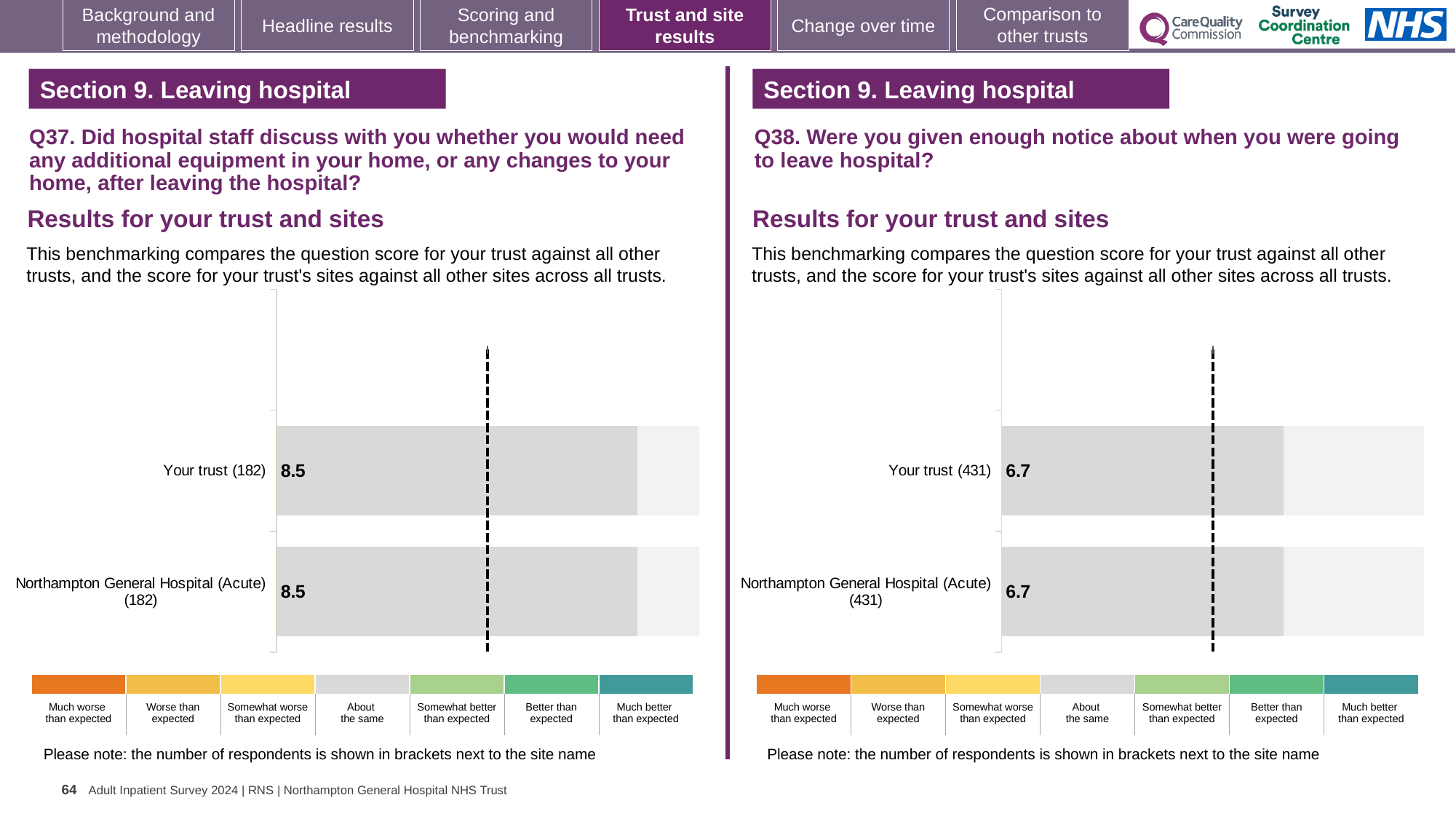
In the Q38 chart on the right, what is the difference between the score for Your trust and the score for Northampton General Hospital (Acute)? 0 In the Q37 chart on the left, what is the difference between the score for Your trust and the score for Northampton General Hospital (Acute)? 0 How many bars are plotted in the Q38 chart on the right? 2 In the Q37 chart on the left, what is the score for Northampton General Hospital (Acute)? 8.5 What kind of chart is used for the Q38 results on the right? Bar chart In the Q37 chart on the left, what is the score for Your trust? 8.5 How many bars are plotted in the Q37 chart on the left? 2 In the Q38 chart on the right, how many respondents are shown in brackets next to Northampton General Hospital (Acute)? 431 How many benchmark categories are listed in the colour key below the Q37 chart on the left? 7 In the Q38 chart on the right, what is the score for Northampton General Hospital (Acute)? 6.7 In the Q37 chart on the left, how many respondents are shown in brackets next to Your trust? 182 In the Q38 chart on the right, what is the score for Your trust? 6.7